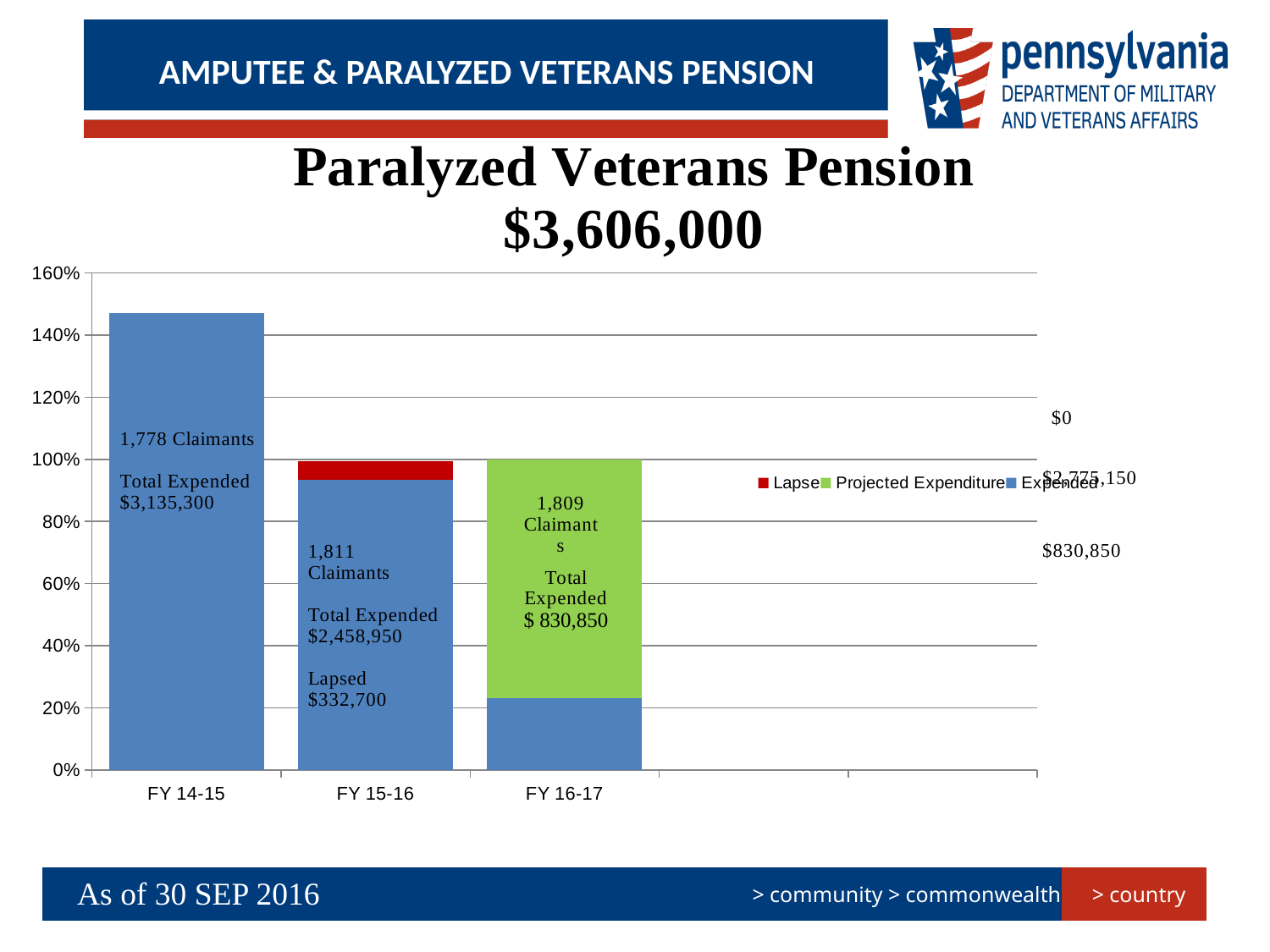
What is the Total Expended amount labelled for FY 14-15? $3,135,300 Which fiscal year has the tallest bar in the chart? FY 14-15 How many claimants are labelled for FY 15-16? 1,811 Claimants Is the Expended portion of the FY 16-17 bar greater or less than 40%? less What are the three series named in the chart legend? Lapse, Projected Expenditure, Expended What colour represents the Projected Expenditure series in the chart? Green What is the Lapsed amount labelled for FY 15-16? $332,700 Which is larger, the Expended portion for FY 15-16 or the Expended portion for FY 16-17? FY 15-16 Is the total bar height for FY 14-15 greater or less than 140%? greater What kind of chart is shown on the slide? Stacked bar chart How many series does the chart legend list? 3 How many fiscal years are shown on the x axis of the chart? 3